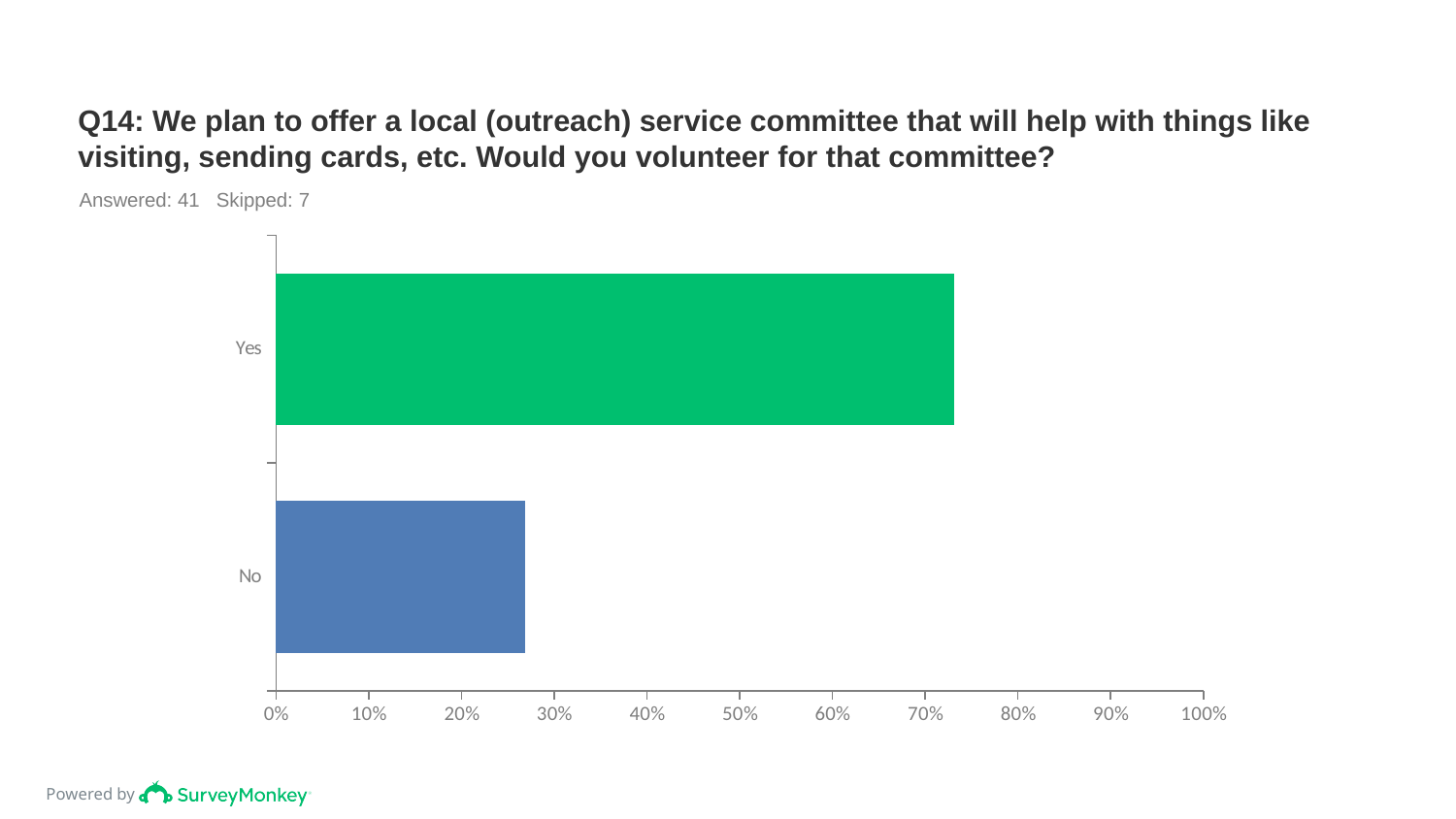
How many respondents answered this question, according to the slide? 41 Is the value for Yes greater or less than 70%? greater Is the value for No greater or less than 30%? less Which category has the highest value? Yes Is the value for Yes greater or less than 80%? less How many respondents skipped this question, according to the slide? 7 What kind of chart is shown on the slide? bar chart Which category has the lowest value? No How many categories are plotted in the chart? 2 Which is larger, the value for Yes or the value for No? Yes